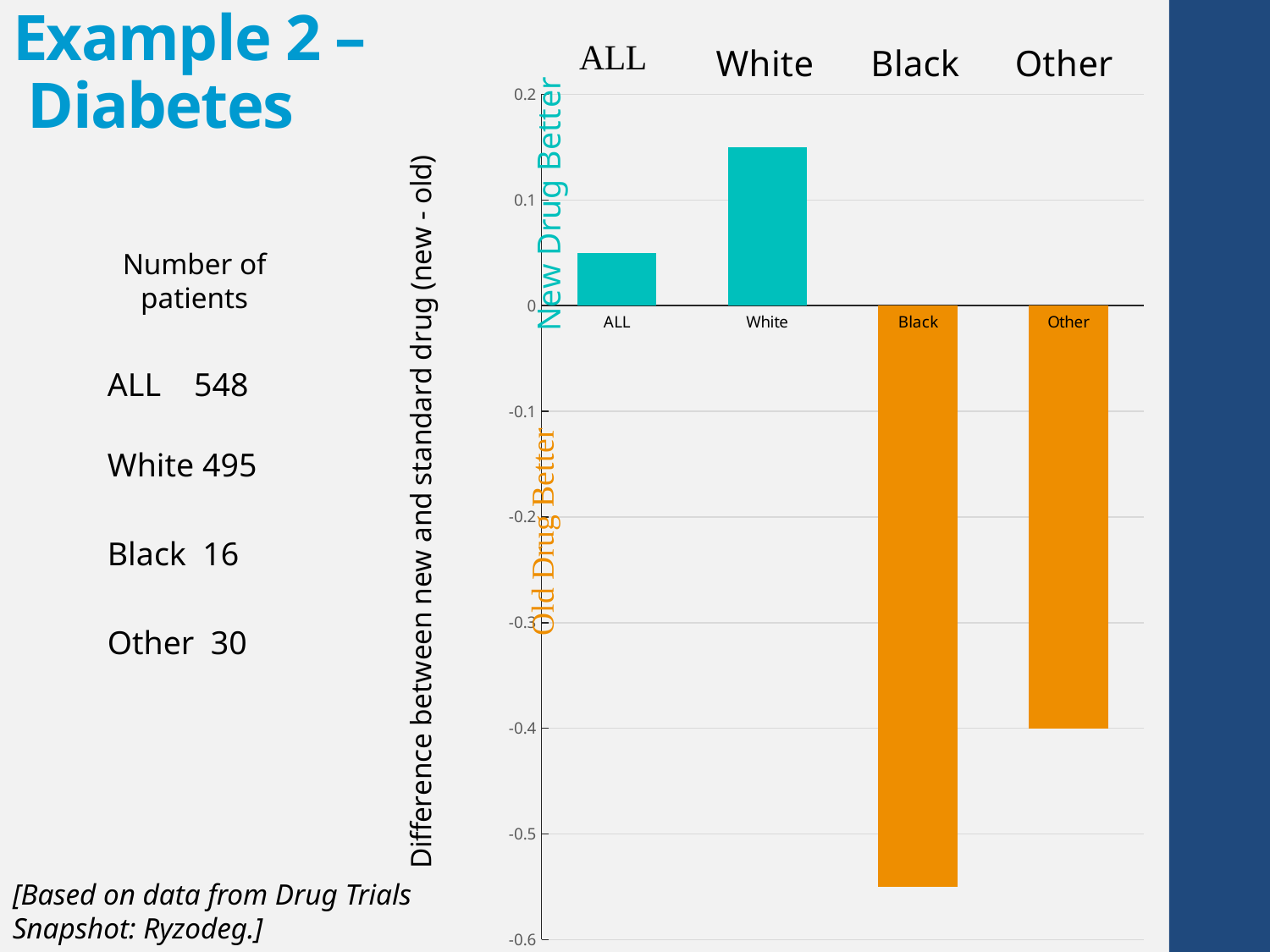
Is the value for Black greater or less than -0.5? less What kind of chart is shown on the slide? bar chart What colour are the bars for Black and Other in the chart? orange Which is larger, the value for Black or the value for Other? Other What is the title of the vertical axis of the chart? Difference between new and standard drug (new - old) Which is larger, the value for White or the value for ALL? White Is the value for White greater or less than 0.1? greater Which category has the lowest value in the chart? Black How many categories are plotted in the chart? 4 Is the value for ALL greater or less than 0.1? less Which category has the highest value in the chart? White